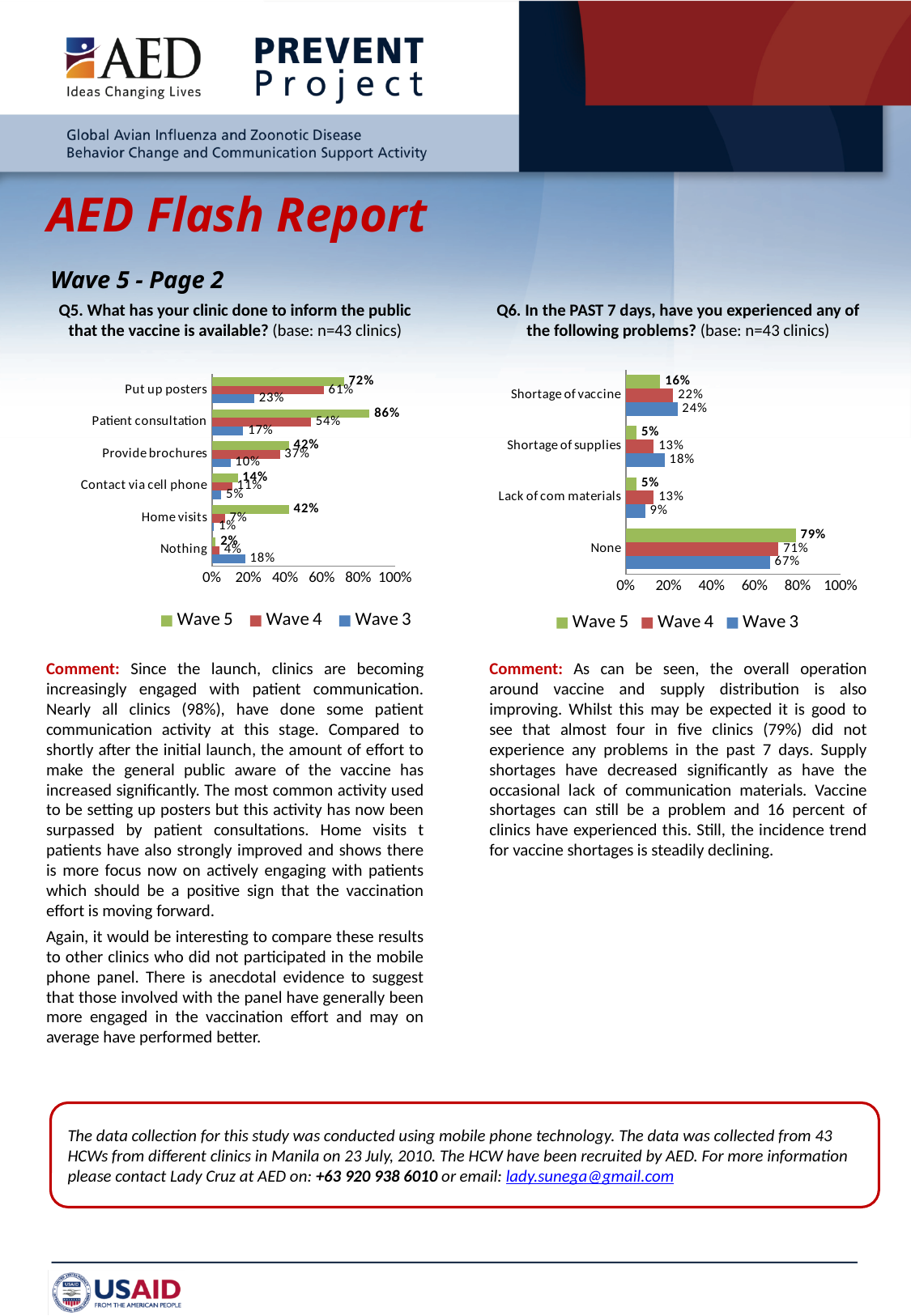
In the Q6 chart on the right, which is larger for Shortage of supplies: the Wave 3 value or the Wave 5 value? Wave 3 In the Q5 chart on the left, what is the Wave 3 value for Put up posters? 23% In the Q5 chart on the left, what is the Wave 5 value for Patient consultation? 86% In the Q5 chart on the left, how many categories are shown? 6 What type of chart is the Q6 chart on the right? Bar chart In the Q5 chart on the left, which category has the highest Wave 5 value? Patient consultation In the Q6 chart on the right, what is the difference between the Wave 3 and Wave 5 values for Shortage of vaccine? 8% In the Q5 chart on the left, which category has the lowest Wave 3 value? Home visits In the Q6 chart on the right, what is the Wave 5 value for None? 79% In the Q5 chart on the left, what is the difference between the Wave 5 and Wave 4 values for Home visits? 35% How many series does the legend of the Q6 chart on the right list? 3 In the Q6 chart on the right, what is the Wave 4 value for Shortage of vaccine? 22%